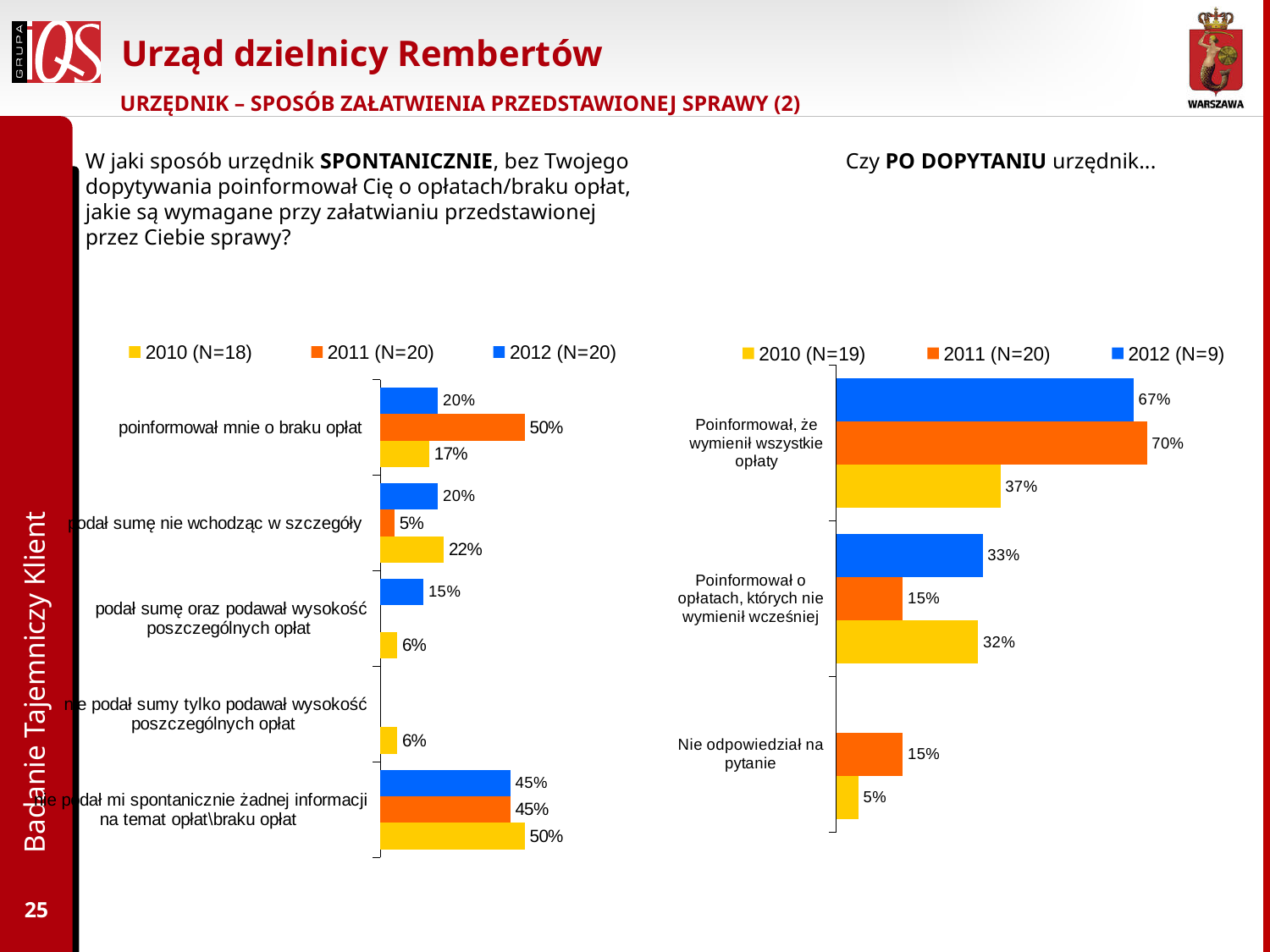
In the left chart (SPONTANICZNIE), how many series does the legend list? 3 In the left chart (SPONTANICZNIE), what is the 2011 (N=20) value for 'poinformował mnie o braku opłat'? 50% What type of chart is the right chart (PO DOPYTANIU)? Bar chart In the right chart (PO DOPYTANIU), what is the 2010 (N=19) value for 'Nie odpowiedział na pytanie'? 5% In the left chart (SPONTANICZNIE), what is the 2010 (N=18) value for 'podał sumę nie wchodząc w szczegóły'? 22% In the right chart (PO DOPYTANIU), how many categories are shown? 3 In the right chart (PO DOPYTANIU), which is larger for 'Poinformował, że wymienił wszystkie opłaty': the 2010 value or the 2012 value? 2012 In the right chart (PO DOPYTANIU), which category has the highest 2010 (N=19) value? Poinformował, że wymienił wszystkie opłaty In the right chart (PO DOPYTANIU), what is the 2011 (N=20) value for 'Poinformował, że wymienił wszystkie opłaty'? 70% In the right chart (PO DOPYTANIU), what is the 2012 (N=9) value for 'Poinformował o opłatach, których nie wymienił wcześniej'? 33% In the left chart (SPONTANICZNIE), what is the difference between the 2011 and 2012 values for 'poinformował mnie o braku opłat'? 30% In the left chart (SPONTANICZNIE), what is the 2012 (N=20) value for 'podał sumę oraz podawał wysokość poszczególnych opłat'? 15%